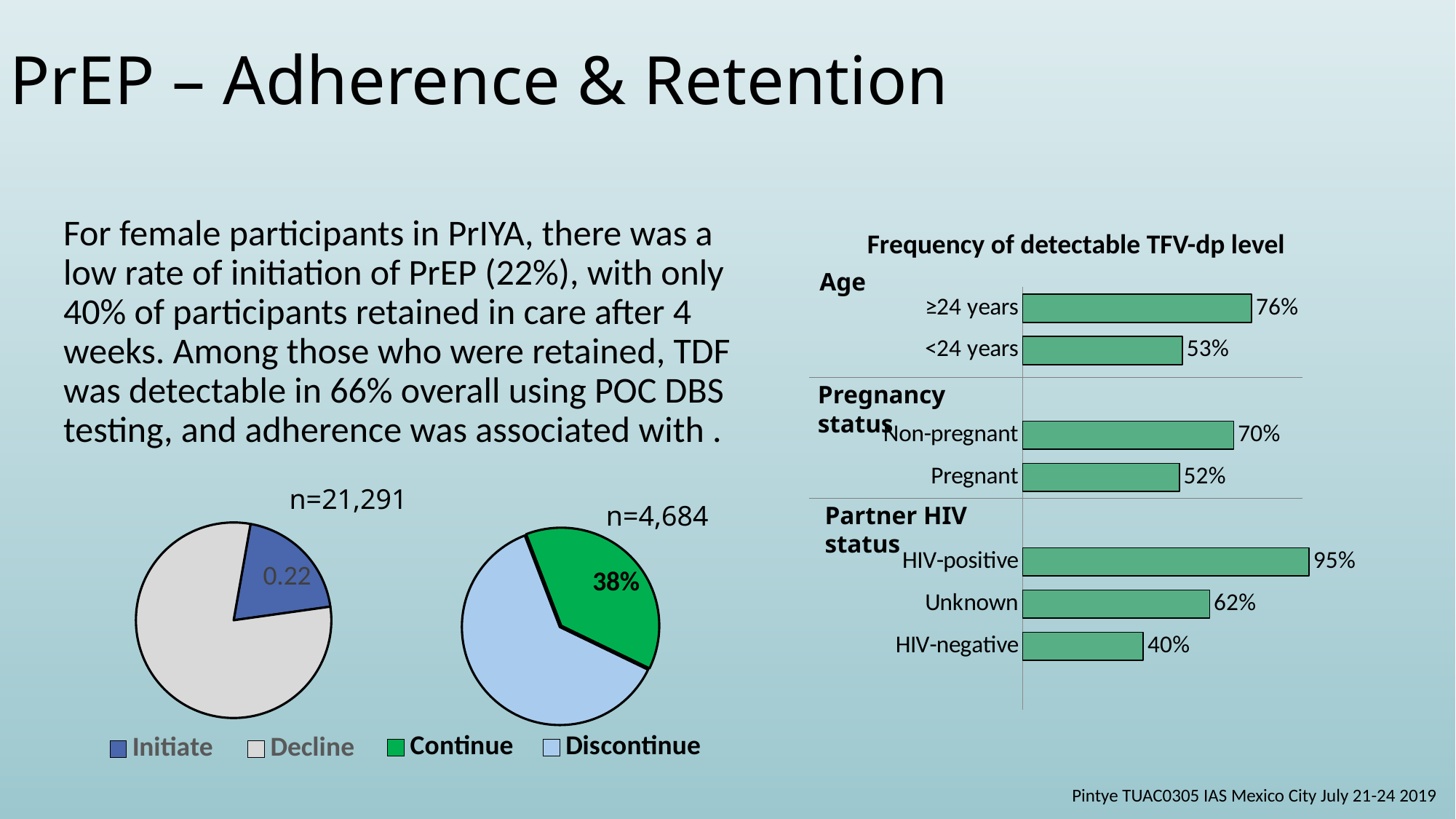
In the pie chart labelled n=21,291, which slice is larger, Initiate or Decline? Decline In the pie chart labelled n=4,684, what share is shown for the Continue slice? 38% How many bars are plotted in the 'Frequency of detectable TFV-dp level' chart? 7 In the 'Frequency of detectable TFV-dp level' bar chart, which category has the lowest value? HIV-negative In the 'Frequency of detectable TFV-dp level' bar chart, which category has the highest value? HIV-positive In the 'Frequency of detectable TFV-dp level' bar chart, which is larger, the value for Non-pregnant or the value for Unknown partner HIV status? Non-pregnant In the pie chart labelled n=21,291, what value is shown for the Initiate slice? 0.22 In the 'Frequency of detectable TFV-dp level' bar chart, what is the value for Pregnant? 52% In the 'Frequency of detectable TFV-dp level' bar chart, what is the value for HIV-positive? 95% How many entries does the legend of the pie chart labelled n=4,684 list? 2 In the 'Frequency of detectable TFV-dp level' bar chart, what is the difference between the values for ≥24 years and <24 years? 23% What kind of chart is the 'Frequency of detectable TFV-dp level' chart? Bar chart